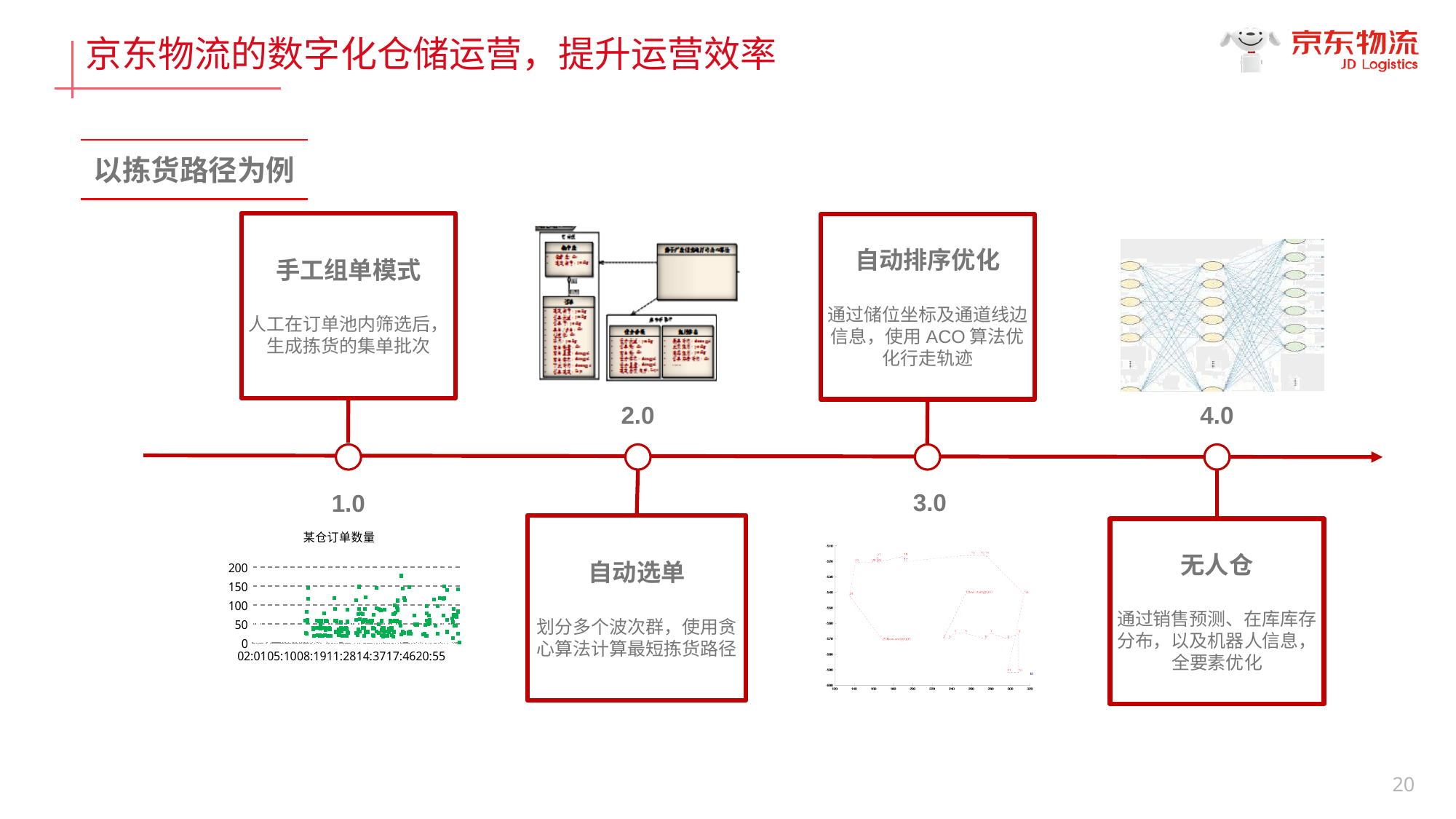
In the chart titled 某仓订单数量, what is the lowest value shown on the y axis? 0 In the chart titled 某仓订单数量, are the plotted values mostly greater or less than 150? less In the chart titled 某仓订单数量, what is the highest value shown on the y axis? 200 What is the title of the chart at the bottom left of the slide? 某仓订单数量 What kind of chart is the chart titled 某仓订单数量? scatter chart